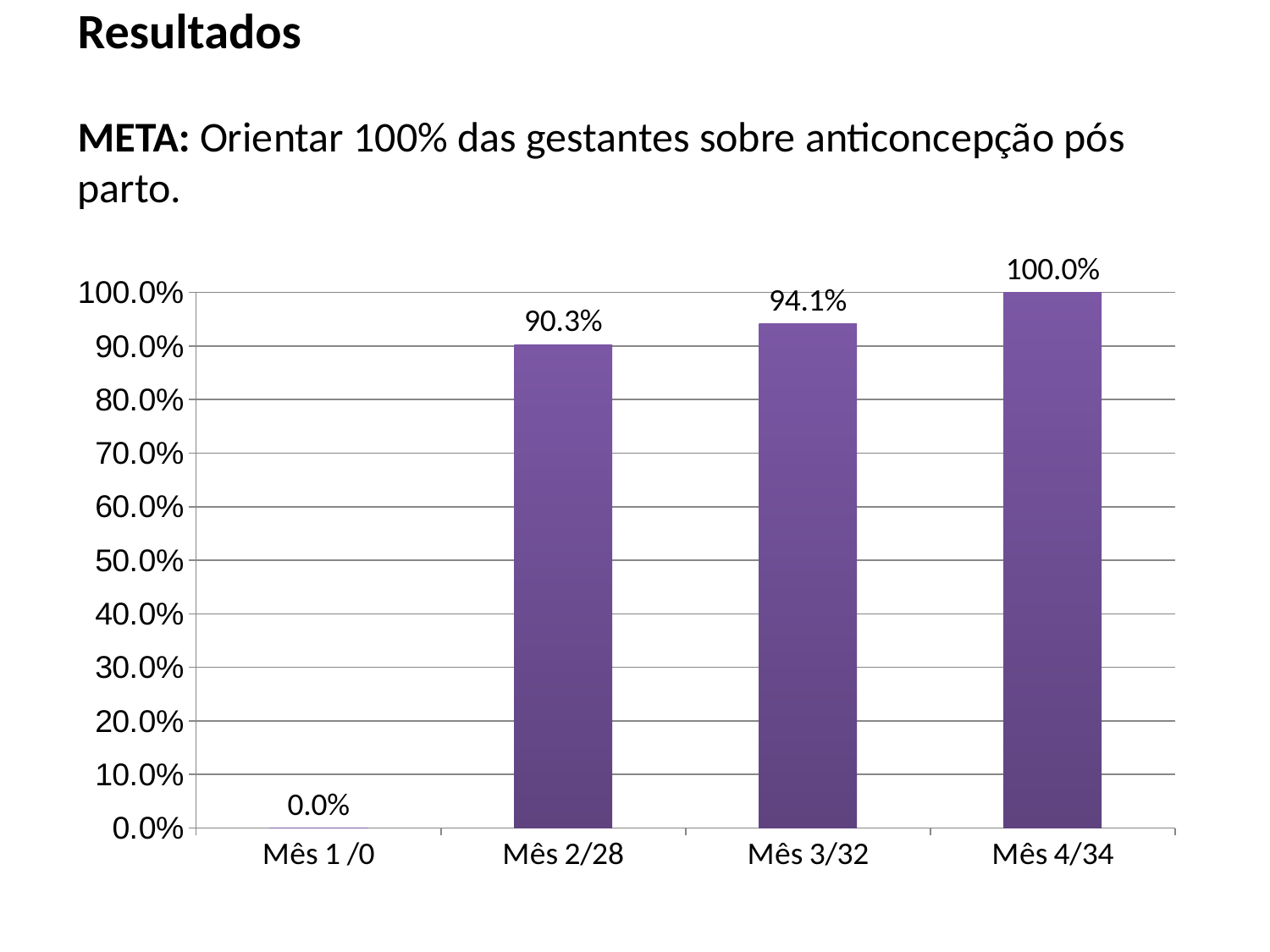
What kind of chart is shown on the slide? Bar chart How many categories are shown on the x axis? 4 Which is larger, the value for Mês 3/32 or the value for Mês 2/28? Mês 3/32 Which category has the lowest value? Mês 1 /0 What is the difference between the values for Mês 4/34 and Mês 2/28? 9.7% Do the values rise or fall from Mês 1 /0 to Mês 4/34? Rise What is the difference between the values for Mês 3/32 and Mês 2/28? 3.8% What is the value for Mês 2/28? 90.3% What is the value for Mês 4/34? 100.0% What is the value for Mês 1 /0? 0.0% What is the value for Mês 3/32? 94.1% Which category has the highest value? Mês 4/34